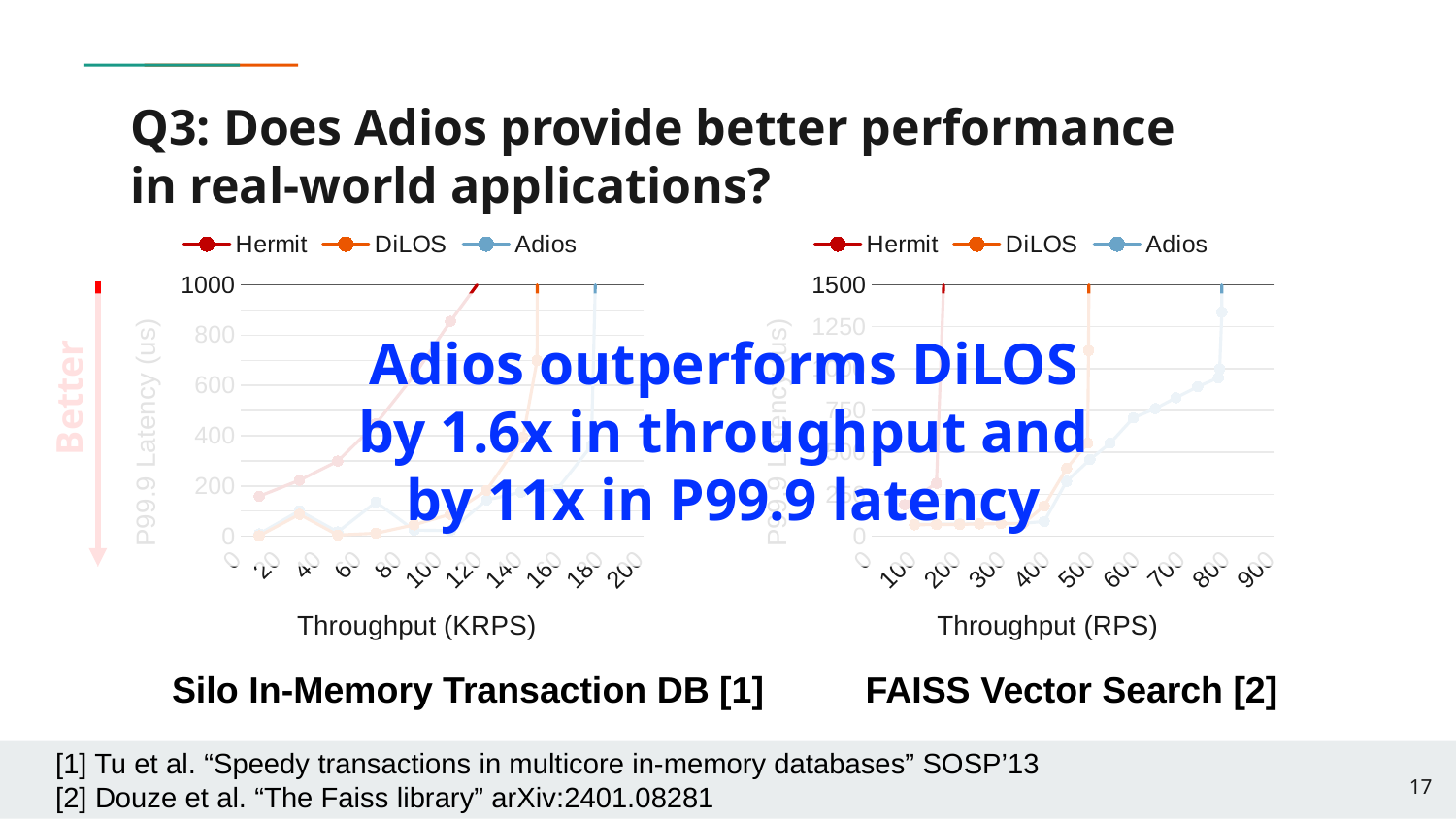
In the FAISS Vector Search chart, which series reaches the highest throughput before its latency shoots up? Adios How many series does the legend of the FAISS Vector Search chart list? 3 In the FAISS Vector Search chart, which series has its latency shoot up at the lowest throughput? Hermit What kind of chart is the Silo In-Memory Transaction DB chart on the left? line chart In the Silo In-Memory Transaction DB chart, which series reaches a higher throughput before its latency spikes, DiLOS or Hermit? DiLOS In the Silo In-Memory Transaction DB chart, which series has its latency shoot up at the lowest throughput? Hermit How many series does the legend of the Silo In-Memory Transaction DB chart list? 3 In the FAISS Vector Search chart, does the P99.9 latency of Adios rise or fall as throughput increases along the x axis? rise What is the x-axis label of the Silo In-Memory Transaction DB chart? Throughput (KRPS) In the Silo In-Memory Transaction DB chart, which series reaches the highest throughput before its latency shoots up? Adios What are the legend entries of the FAISS Vector Search chart? Hermit, DiLOS, Adios What kind of chart is the FAISS Vector Search chart on the right? line chart